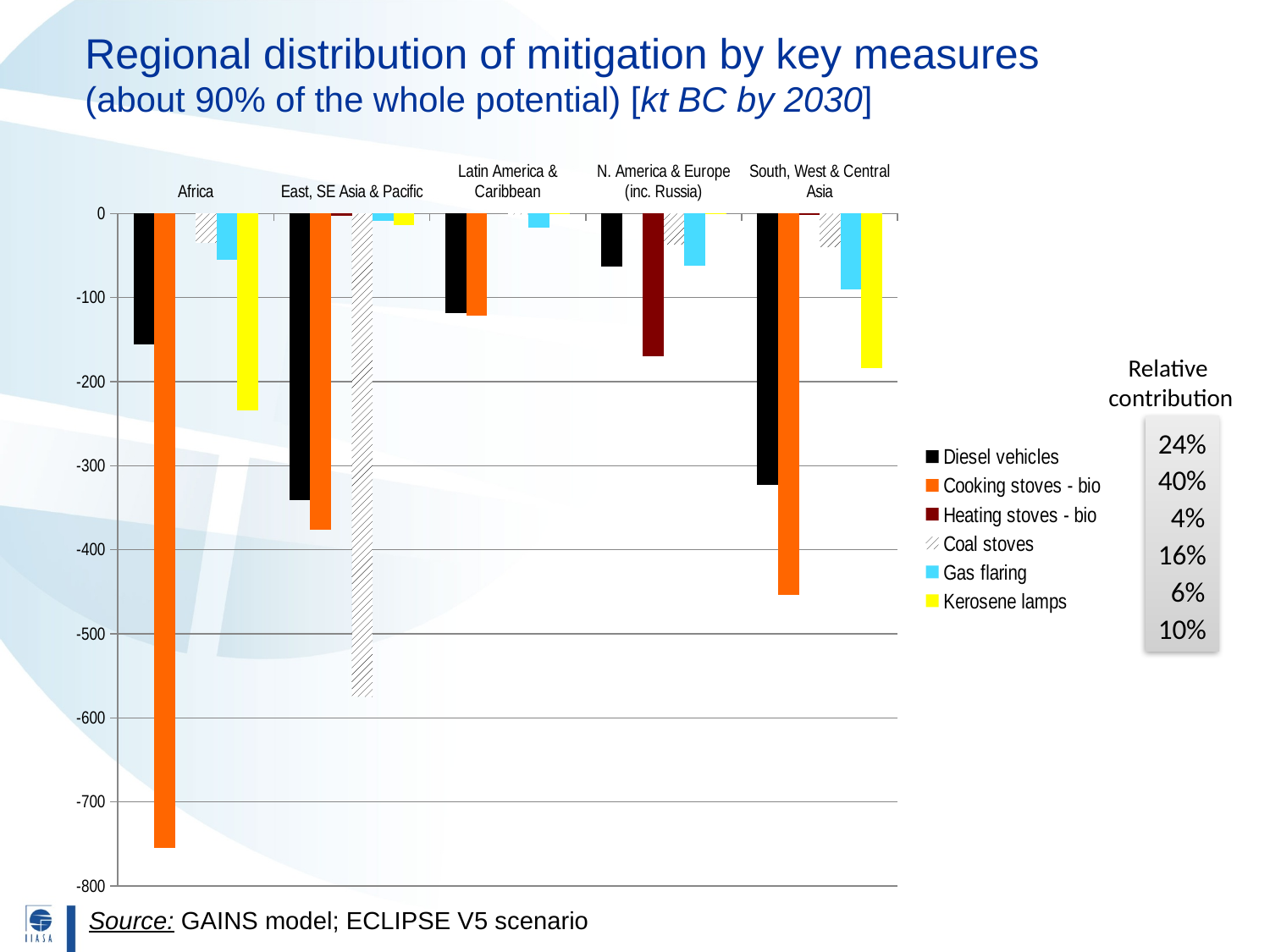
How many series does the chart's legend list? 6 Which region has the longest (most negative) bar for Heating stoves - bio? N. America & Europe (inc. Russia) Which region has the longest (most negative) bar for Cooking stoves - bio? Africa According to the 'Relative contribution' box, what is the relative contribution of Cooking stoves - bio? 40% Is the value for Cooking stoves - bio in Africa greater or less than -700? less Which measure has the longest (most negative) bar in South, West & Central Asia? Cooking stoves - bio Is the value for Diesel vehicles in Latin America & Caribbean greater or less than -200? greater What kind of chart is shown on the slide? bar chart How many regions are shown along the x axis of the chart? 5 Which region has the longer (more negative) Diesel vehicles bar, Africa or East, SE Asia & Pacific? East, SE Asia & Pacific Is the value for Diesel vehicles in Africa greater or less than -100? less